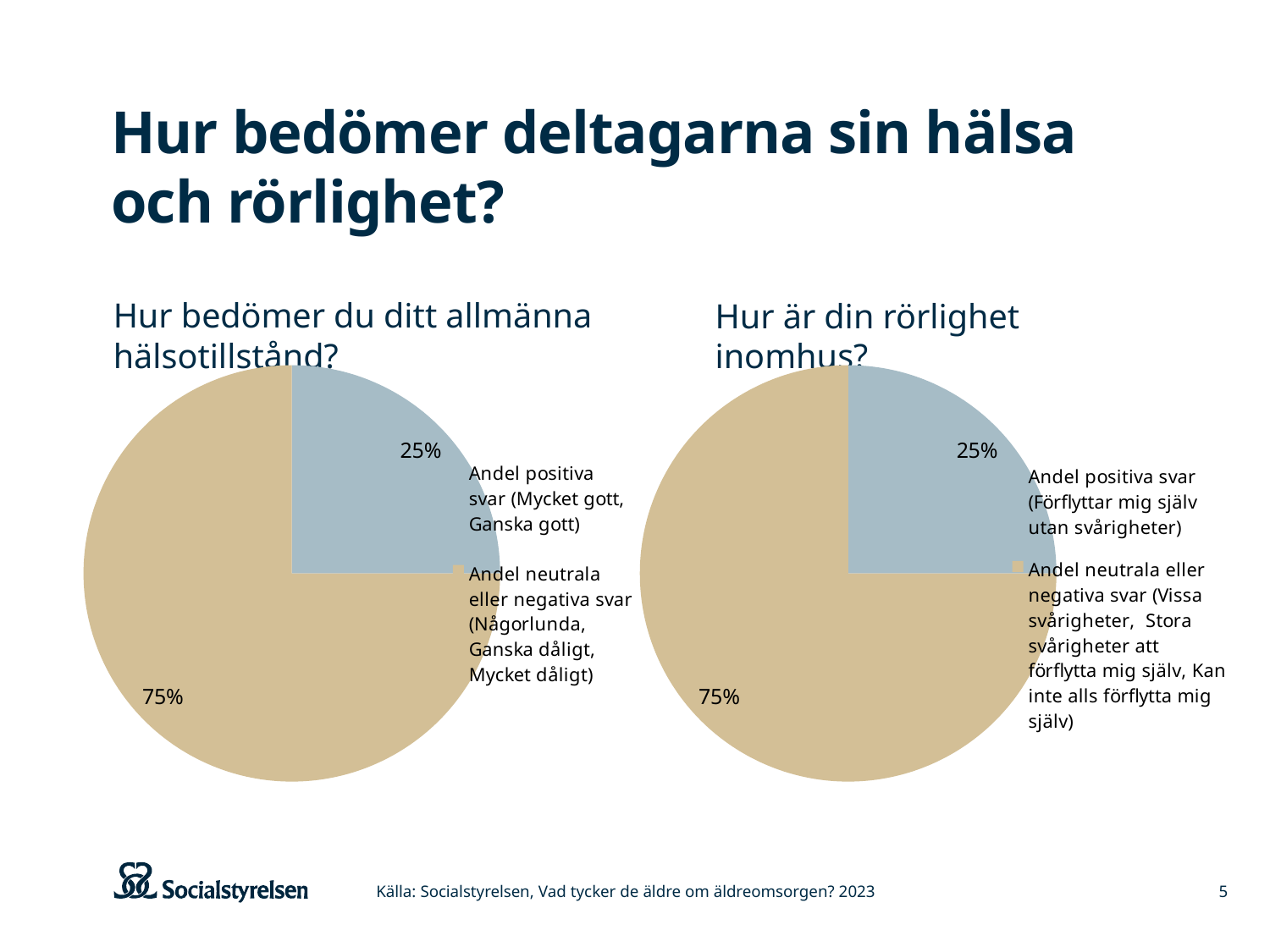
In the right chart 'Hur är din rörlighet inomhus?', what share is labelled for 'Andel neutrala eller negativa svar'? 75% In the left chart 'Hur bedömer du ditt allmänna hälsotillstånd?', what is the difference in percentage points between the neutral/negative share and the positive share? 50 percentage points In the left chart 'Hur bedömer du ditt allmänna hälsotillstånd?', what colour is the slice for 'Andel positiva svar'? Blue-grey In the left chart 'Hur bedömer du ditt allmänna hälsotillstånd?', which category has the largest slice? Andel neutrala eller negativa svar In the right chart 'Hur är din rörlighet inomhus?', is the share for 'Andel positiva svar' larger or smaller than the share for 'Andel neutrala eller negativa svar'? Smaller In the left chart 'Hur bedömer du ditt allmänna hälsotillstånd?', what share is labelled for 'Andel positiva svar'? 25% How many entries does the legend of the left chart 'Hur bedömer du ditt allmänna hälsotillstånd?' list? 2 What kind of chart is used for 'Hur bedömer du ditt allmänna hälsotillstånd?'? Pie chart How many slices does the right chart 'Hur är din rörlighet inomhus?' have? 2 In the right chart 'Hur är din rörlighet inomhus?', which category has the smallest slice? Andel positiva svar In the left chart 'Hur bedömer du ditt allmänna hälsotillstånd?', what share is labelled for 'Andel neutrala eller negativa svar'? 75% In the right chart 'Hur är din rörlighet inomhus?', what share is labelled for 'Andel positiva svar'? 25%